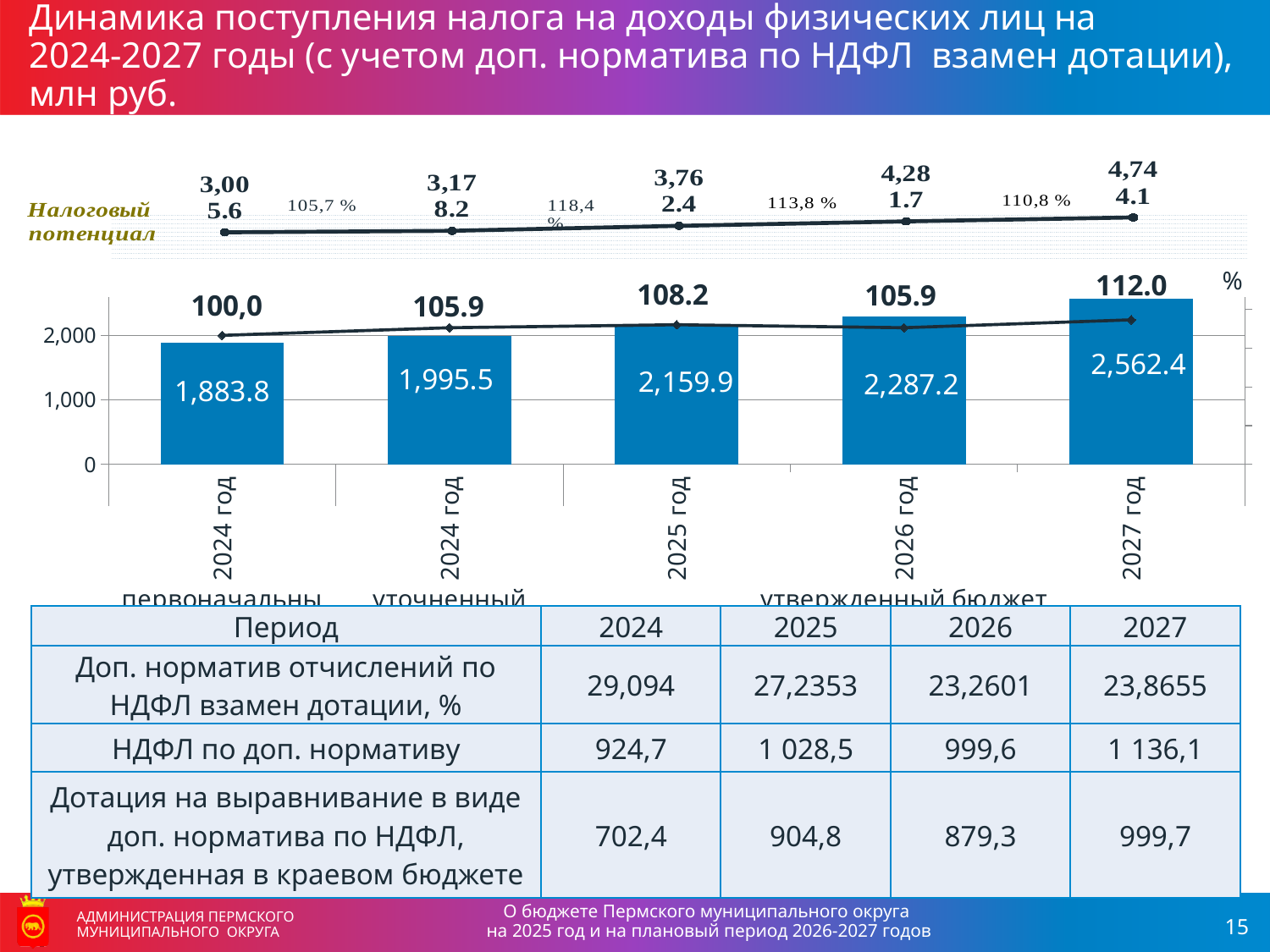
Which bar has the lowest value? 2024 год (первоначальный) What is the difference between the bar values for 2027 год and 2026 год? 275.2 Which is larger, the bar for 2024 год (уточненный) or the bar for 2025 год? 2025 год Which bar has the highest value? 2027 год How many bars are shown in the bar chart? 5 What is the value of the bar for 2027 год? 2,562.4 What is the value of the bar for 2025 год? 2,159.9 Is the value of the bar for 2024 год (уточненный) greater or less than 2,000? less What is the value of the first bar, 2024 год (первоначальный бюджет)? 1,883.8 Do the bar values rise or fall from left to right across the years? rise What is the value of the bar for 2026 год? 2,287.2 What type of chart is used to show the НДФЛ values in млн руб.? bar chart